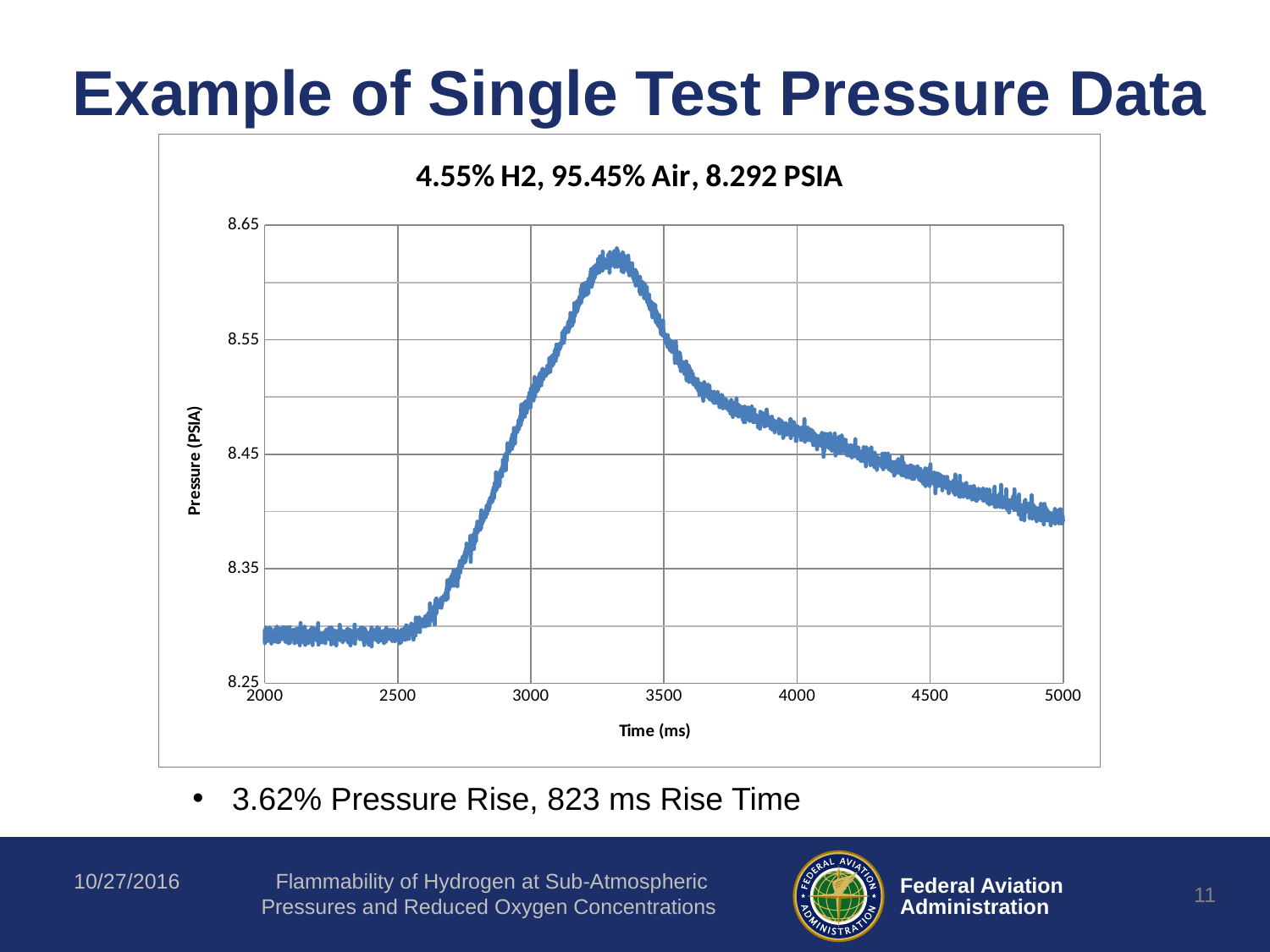
Is the peak pressure on the chart greater or less than 8.65 PSIA? less What is the label of the vertical axis of the chart? Pressure (PSIA) Is the pressure at 5000 ms greater or less than 8.45 PSIA? less Is the pressure at 4000 ms greater or less than 8.55 PSIA? less Does the pressure rise or fall between 2500 ms and 3000 ms? rise What is the title of the chart? 4.55% H2, 95.45% Air, 8.292 PSIA What kind of chart is shown on the slide? line chart Is the pressure at 3500 ms higher or lower than the pressure at 2500 ms? higher Does the pressure rise or fall between 4000 ms and 5000 ms? fall